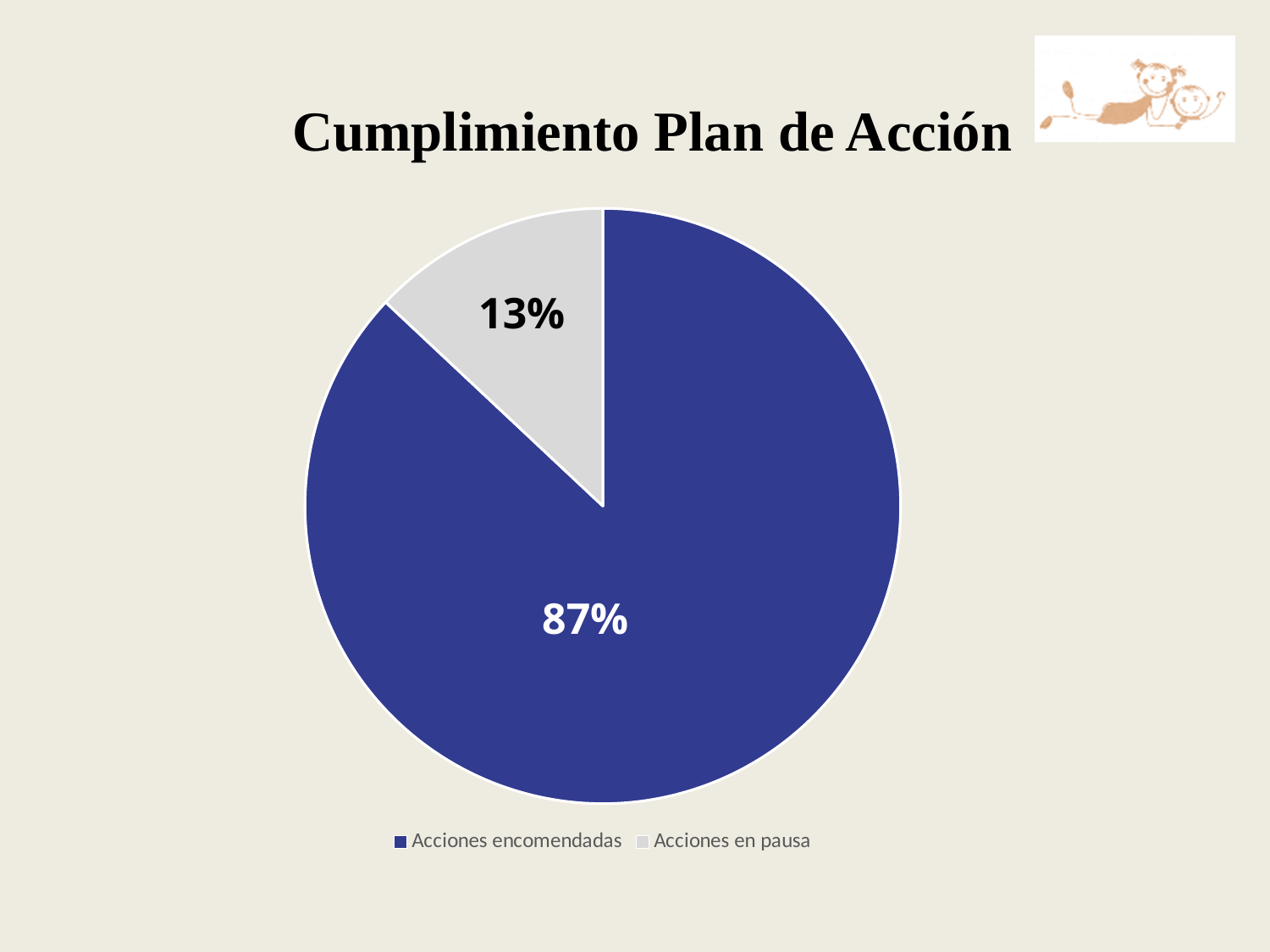
What share of the pie does "Acciones en pausa" represent? 13% What is the title of the chart? Cumplimiento Plan de Acción What is the difference in percentage points between "Acciones encomendadas" and "Acciones en pausa"? 74 What kind of chart is shown on the slide? pie chart What share of the pie does "Acciones encomendadas" represent? 87% Which is larger, "Acciones encomendadas" or "Acciones en pausa"? Acciones encomendadas What colour is the "Acciones encomendadas" slice? blue How many slices does the pie chart have? 2 How many entries does the legend list? 2 Which slice of the pie is the largest? Acciones encomendadas Which slice of the pie is the smallest? Acciones en pausa